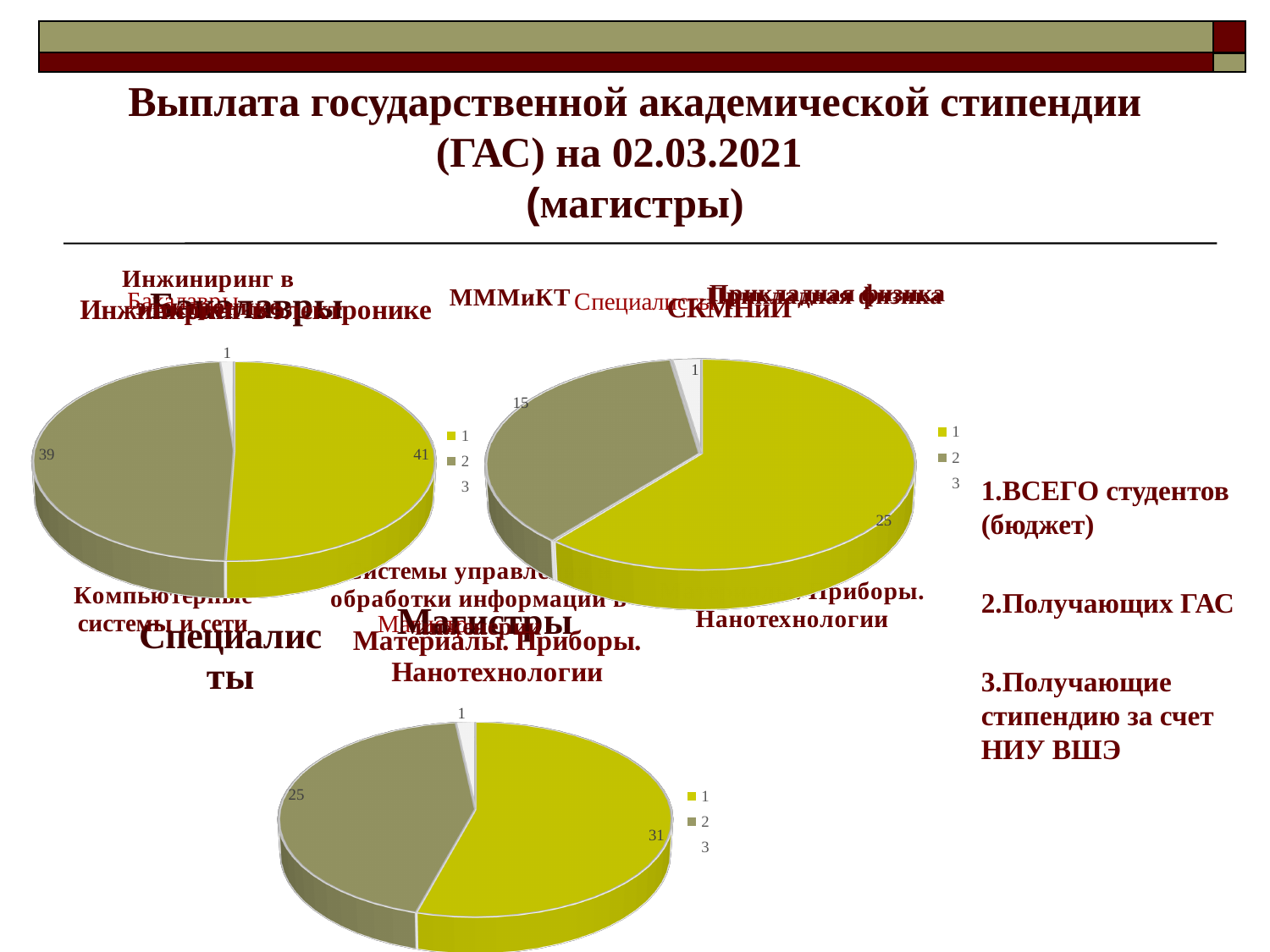
In the top-right pie chart, what is the value of the largest slice? 25 In the top-left pie chart, what is the value of the slice labelled 1 (yellow)? 41 How many entries does the legend of the bottom chart list? 3 In the bottom pie chart, what is the value of the yellow slice (series 1)? 31 In the top-right pie chart, what is the value of the olive slice (series 2)? 15 In the top-left pie chart, what is the value of the slice labelled 2 (olive)? 39 How many slices does the top-left pie chart have? 3 In the bottom pie chart, what is the difference between the values of series 1 and series 2? 6 In the top-right pie chart, what is the difference between the values of series 1 and series 2? 10 What type of chart is the top-right chart? pie chart In the bottom pie chart, what is the value of the smallest slice? 1 In the top-left pie chart, which is larger: the value for series 1 or the value for series 3? series 1